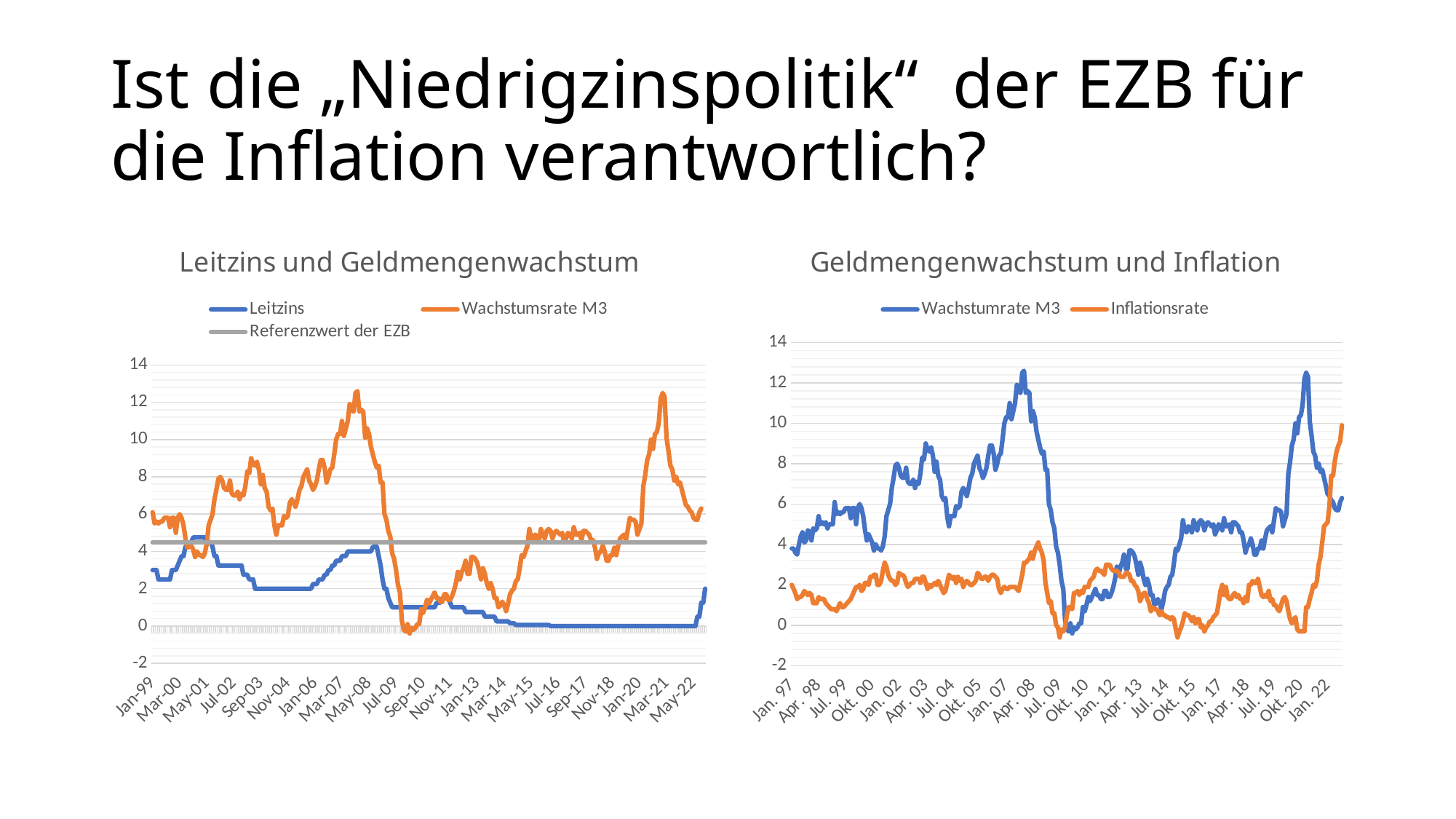
In the right chart "Geldmengenwachstum und Inflation", which series is higher around Apr. 08, Wachstumrate M3 or Inflationsrate? Wachstumrate M3 In the left chart "Leitzins und Geldmengenwachstum", which series is drawn as a flat grey line? Referenzwert der EZB How many series does the legend of the right chart "Geldmengenwachstum und Inflation" list? 2 In the right chart "Geldmengenwachstum und Inflation", what are the two legend entries? Wachstumrate M3, Inflationsrate In the left chart "Leitzins und Geldmengenwachstum", is the peak value of Wachstumsrate M3 around May-08 greater or less than 10? greater In the left chart "Leitzins und Geldmengenwachstum", is the value of Leitzins at Jul-16 greater or less than 2? less In the left chart "Leitzins und Geldmengenwachstum", which series reaches the highest value on the chart? Wachstumsrate M3 In the right chart "Geldmengenwachstum und Inflation", is the value of Inflationsrate around Jul. 09 greater or less than 2? less In the right chart "Geldmengenwachstum und Inflation", does the Inflationsrate rise or fall from Okt. 20 to the end of the series? rise What kind of chart is the left chart titled "Leitzins und Geldmengenwachstum"? line chart How many series does the legend of the left chart "Leitzins und Geldmengenwachstum" list? 3